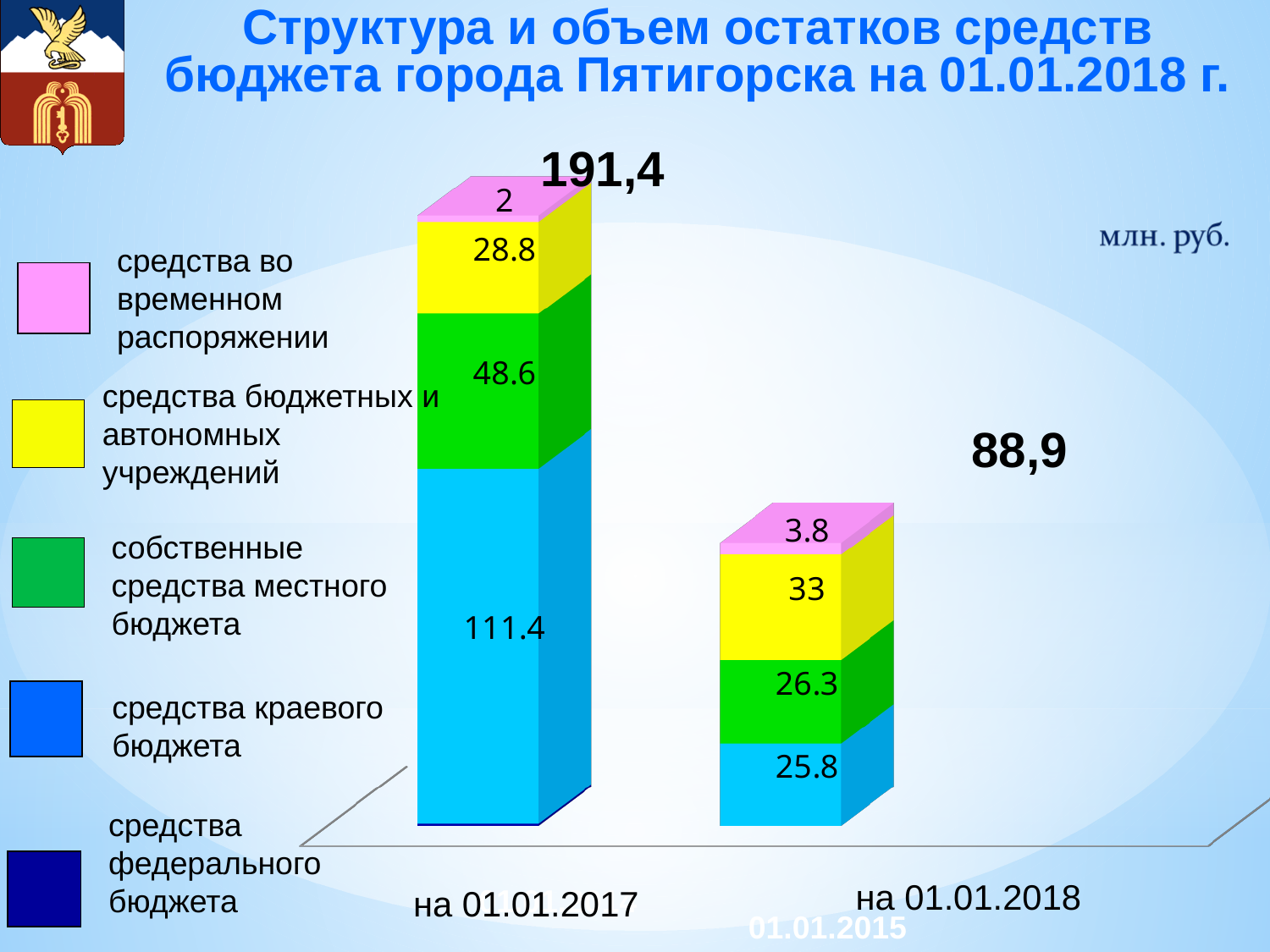
What is the value of средства бюджетных и автономных учреждений for на 01.01.2017? 28.8 What is the value of средства краевого бюджета for на 01.01.2017? 111.4 How many entries does the legend list? 5 Which segment is the smallest in the bar на 01.01.2018? средства во временном распоряжении Which is larger: средства бюджетных и автономных учреждений on 01.01.2017 or on 01.01.2018? на 01.01.2018 What is the value of средства во временном распоряжении for на 01.01.2018? 3.8 What is the total shown for the bar на 01.01.2018? 88,9 Which segment is the largest in the bar на 01.01.2017? средства краевого бюджета What kind of chart is shown on the slide? stacked bar chart What is the difference between средства краевого бюджета on 01.01.2017 and on 01.01.2018? 85.6 What is the value of собственные средства местного бюджета for на 01.01.2018? 26.3 What is the total shown for the bar на 01.01.2017? 191,4